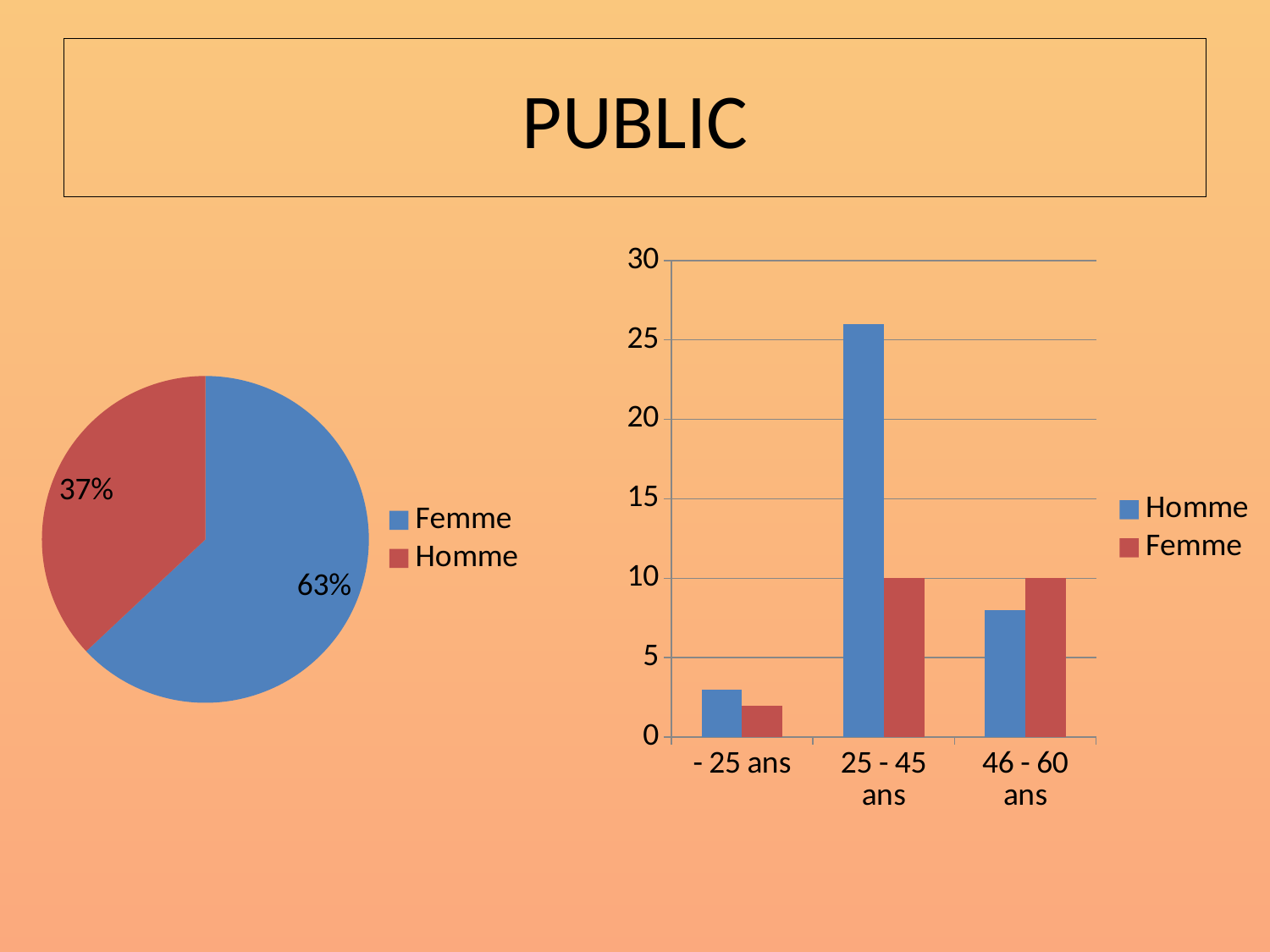
In the bar chart on the right, which age category has the highest value for Homme? 25 - 45 ans What kind of chart is the chart on the right of the slide? bar chart In the pie chart on the left, which slice is larger, Femme or Homme? Femme In the pie chart on the left, what share of the pie is Femme? 63% In the bar chart on the right, is the value for Homme in the 46 - 60 ans category greater or less than 10? less In the bar chart on the right, how many age categories are shown on the x axis? 3 In the bar chart on the right, which age category has the lowest value for Femme? - 25 ans In the bar chart on the right, which is larger for the 46 - 60 ans category, Homme or Femme? Femme In the bar chart on the right, how many series does the legend list? 2 In the pie chart on the left, what share of the pie is Homme? 37% What kind of chart is the chart on the left of the slide? pie chart In the bar chart on the right, is the value for Homme in the 25 - 45 ans category greater or less than 20? greater